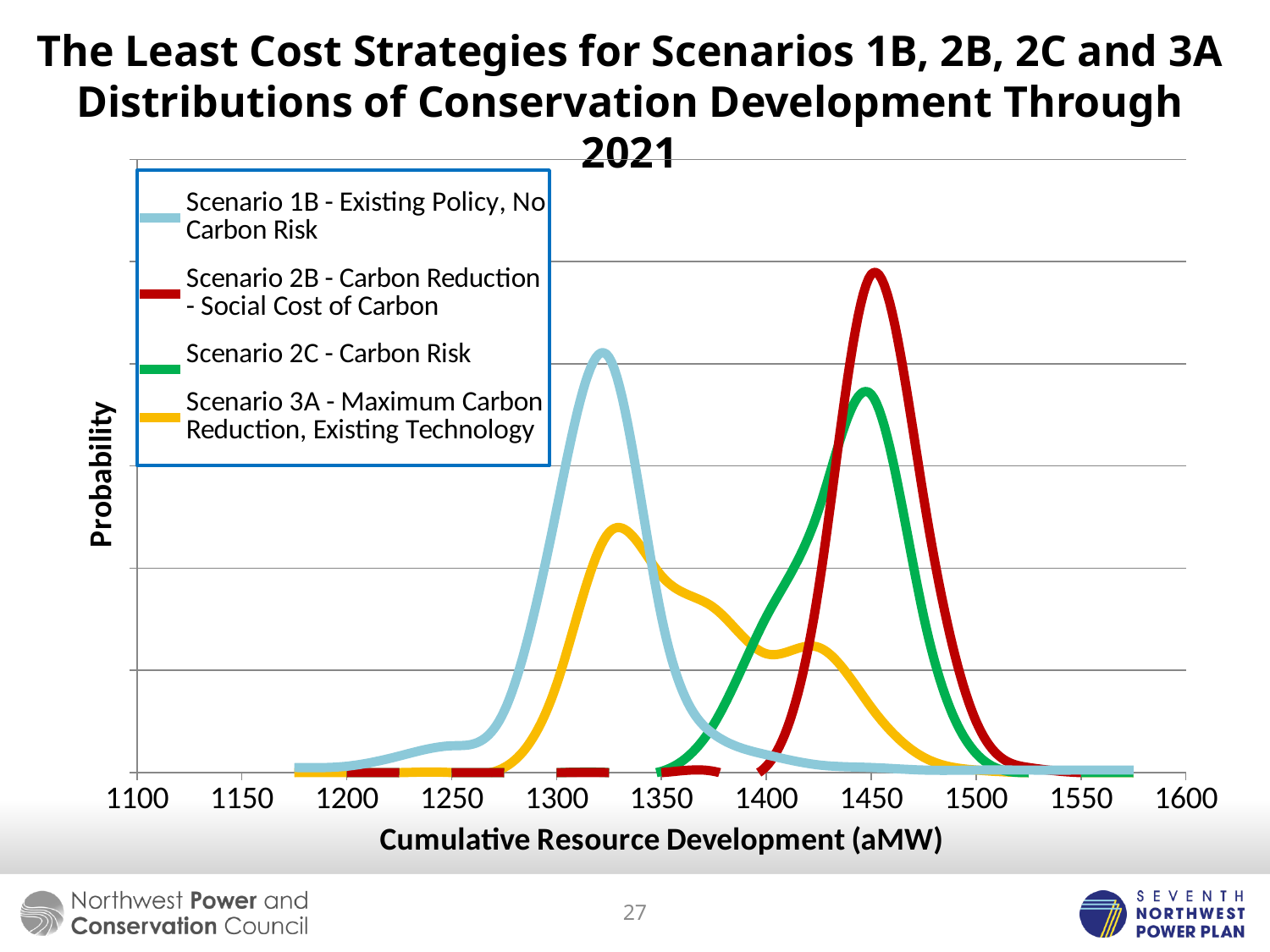
What colour is the line for Scenario 2C - Carbon Risk? Green Which scenario's distribution has the lowest peak probability? Scenario 3A - Maximum Carbon Reduction, Existing Technology How many labelled tick values are shown on the x axis? 11 How many series does the legend list? 4 Which scenario's distribution reaches the highest peak probability? Scenario 2B - Carbon Reduction - Social Cost of Carbon Which peaks at a higher probability, Scenario 2B or Scenario 2C? Scenario 2B What is the label of the x axis? Cumulative Resource Development (aMW) Which peaks at a higher probability, Scenario 1B or Scenario 3A? Scenario 1B What kind of chart is shown on the slide? Line chart Is the cumulative resource development at the peak of Scenario 1B greater or less than 1350 aMW? less Is the cumulative resource development at the peak of Scenario 2B greater or less than 1400 aMW? greater